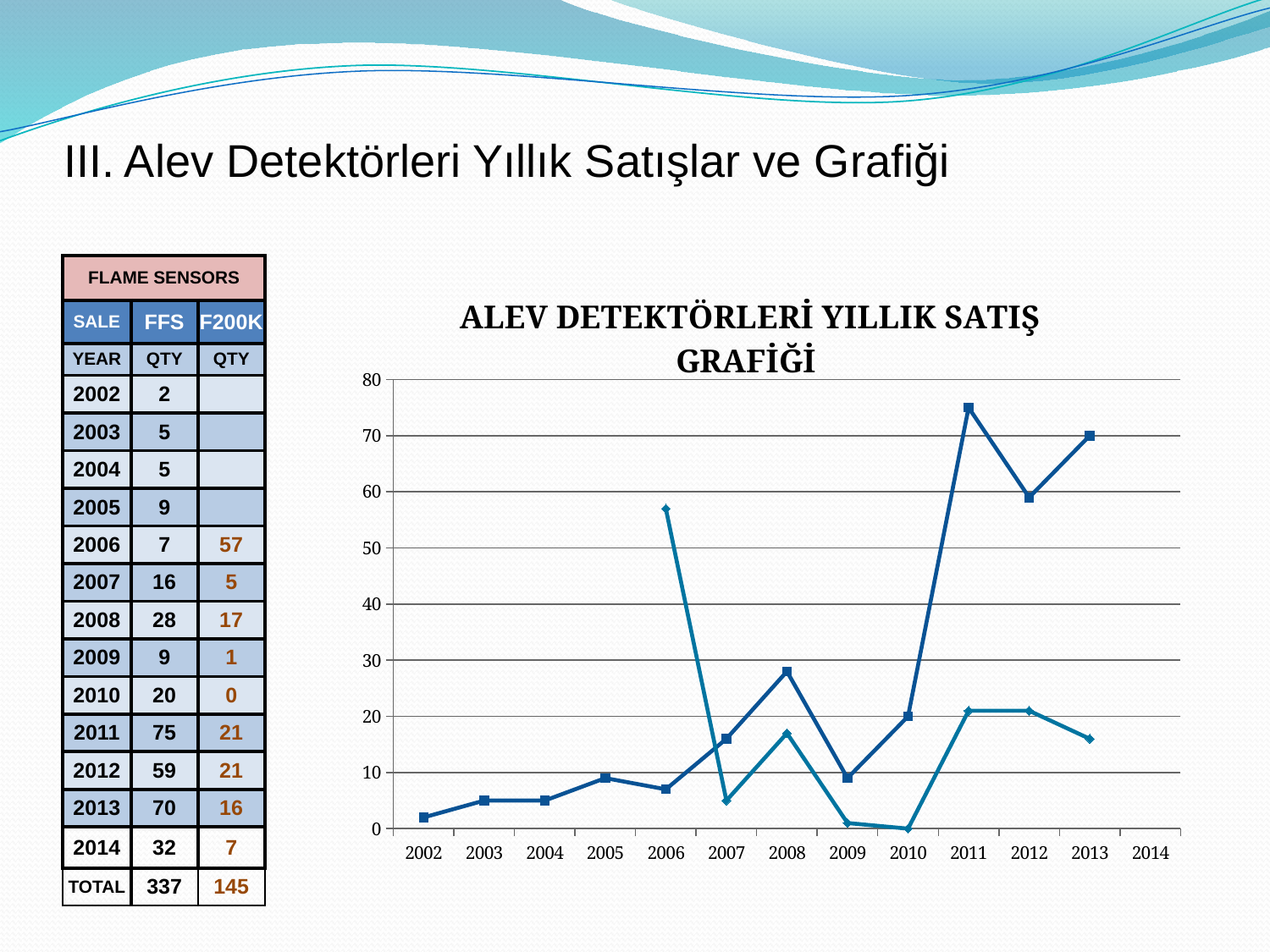
In 2011, which line is higher: the darker blue line with square markers or the lighter blue line with diamond markers? the darker blue line with square markers How many year labels are shown on the x axis of the chart? 13 In which year does the lighter blue line with diamond markers reach its highest point? 2006 What is the title of the chart? ALEV DETEKTÖRLERİ YILLIK SATIŞ GRAFİĞİ What kind of chart is shown on the slide? line chart What value does the darker blue line with square markers have in 2010? 20 How many lines are plotted on the chart? 2 Is the value of the lighter blue line with diamond markers in 2006 greater or less than 50? greater In which year is the lighter blue line with diamond markers at its lowest point? 2010 Does the darker blue line with square markers rise or fall from 2002 to 2005? rise In which year is the darker blue line with square markers at its lowest point? 2002 In which year does the darker blue line with square markers reach its highest point? 2011